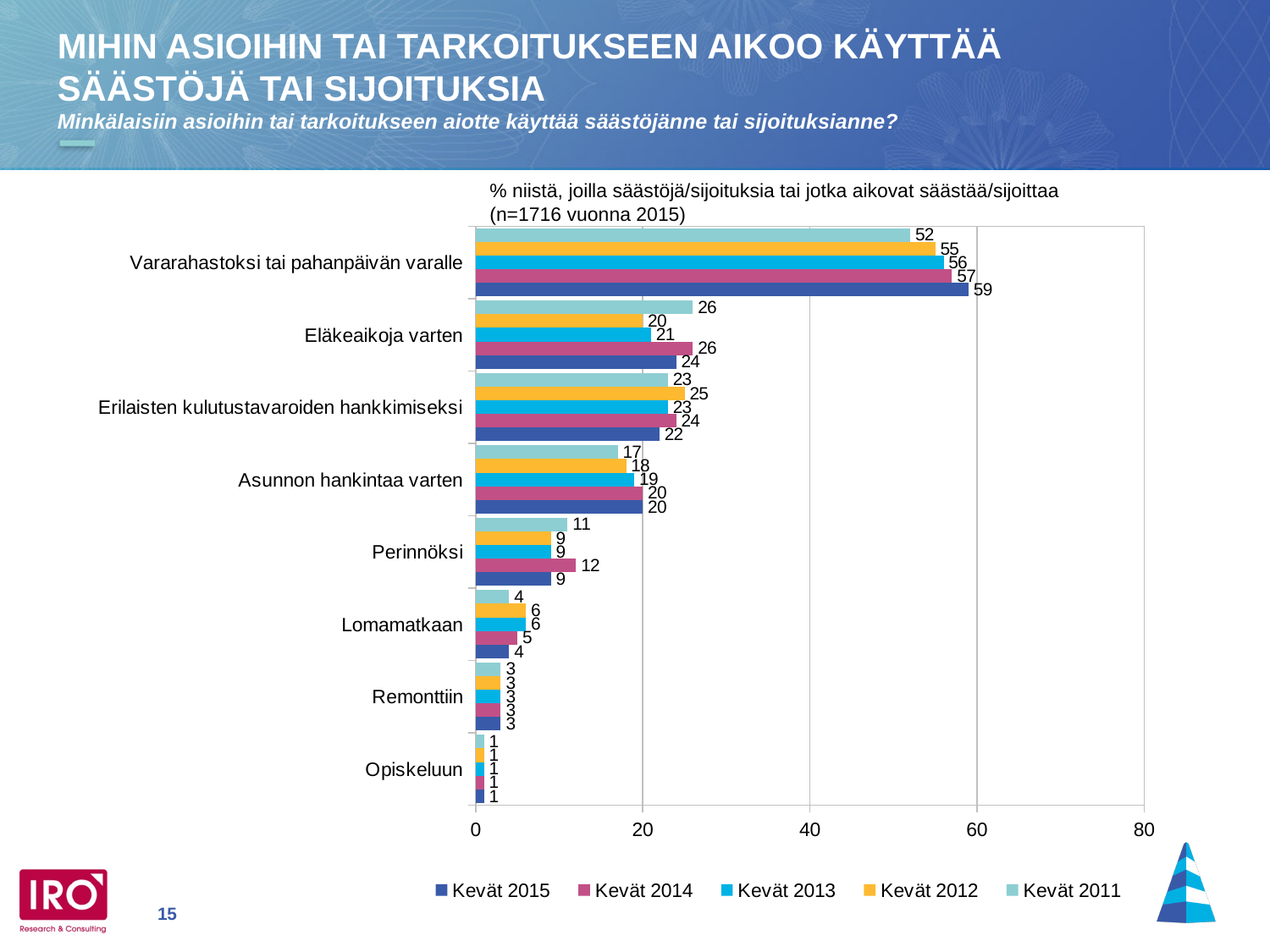
What is the difference between the Kevät 2015 and Kevät 2011 values for 'Vararahastoksi tai pahanpäivän varalle'? 7 Which category has the highest value in the Kevät 2015 series? Vararahastoksi tai pahanpäivän varalle How many categories are shown on the chart? 8 Which series is listed first in the legend? Kevät 2015 What kind of chart is shown on the slide? bar chart For 'Lomamatkaan', which is larger: the Kevät 2013 value or the Kevät 2015 value? Kevät 2013 What is the value for 'Vararahastoksi tai pahanpäivän varalle' in the Kevät 2015 series? 59 What is the value for 'Eläkeaikoja varten' in the Kevät 2012 series? 20 What is the value for 'Perinnöksi' in the Kevät 2014 series? 12 Is the Kevät 2014 value for 'Erilaisten kulutustavaroiden hankkimiseksi' greater or less than 20? greater How many series does the legend list? 5 Which category has the lowest value in the Kevät 2013 series? Opiskeluun